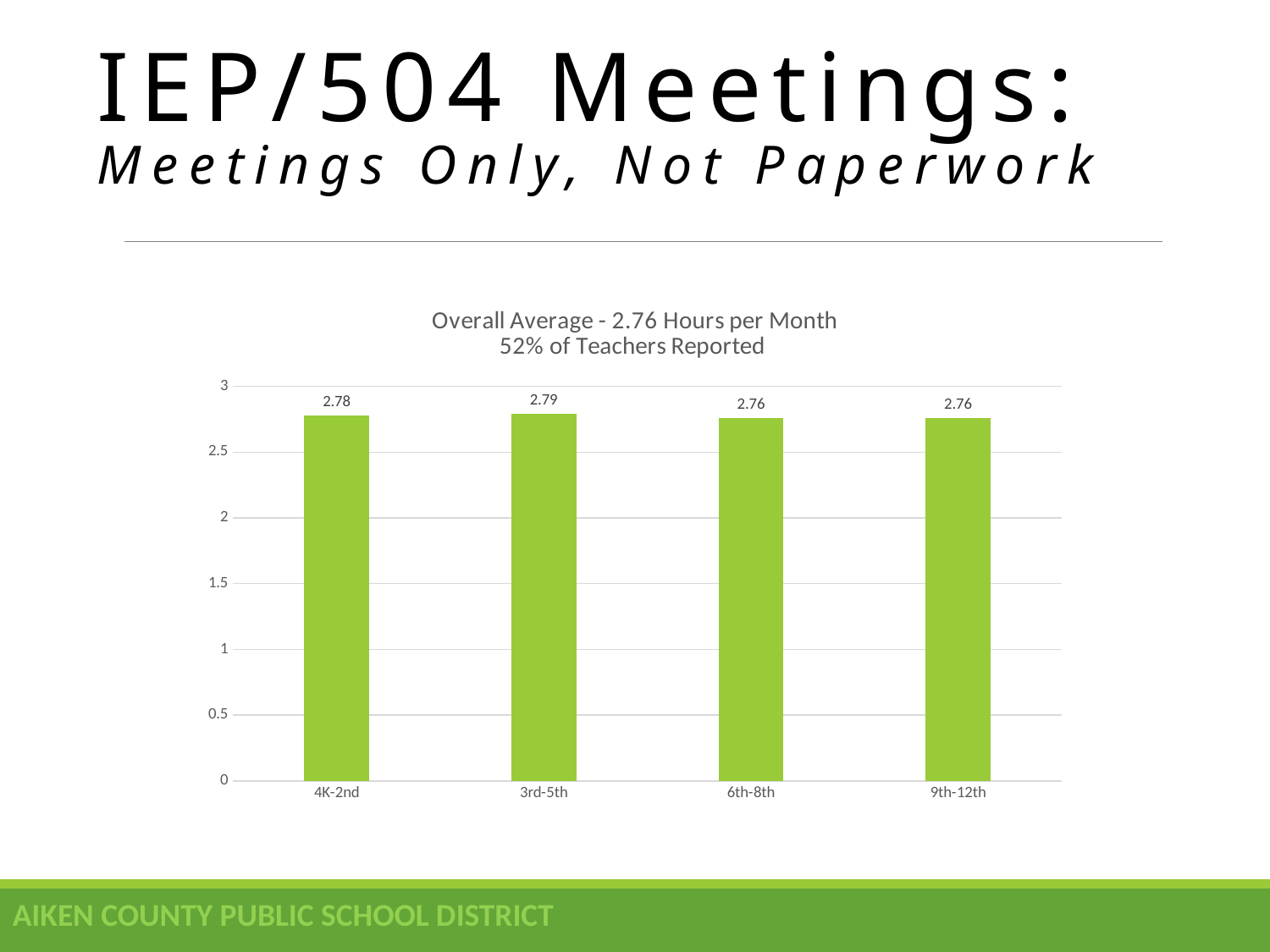
What overall average is stated in the chart title? 2.76 Hours per Month What is the value for 4K-2nd? 2.78 What is the value for 9th-12th? 2.76 Is the value for 6th-8th greater or less than 2.5? greater What is the value for 3rd-5th? 2.79 What kind of chart is shown on the slide? Bar chart Which has the larger value, 4K-2nd or 3rd-5th? 3rd-5th What is the difference between the values for 3rd-5th and 6th-8th? 0.03 What is the difference between the values for 4K-2nd and 9th-12th? 0.02 How many grade bands are shown on the x axis? 4 What is the value for 6th-8th? 2.76 Which grade band has the highest value according to the data labels? 3rd-5th